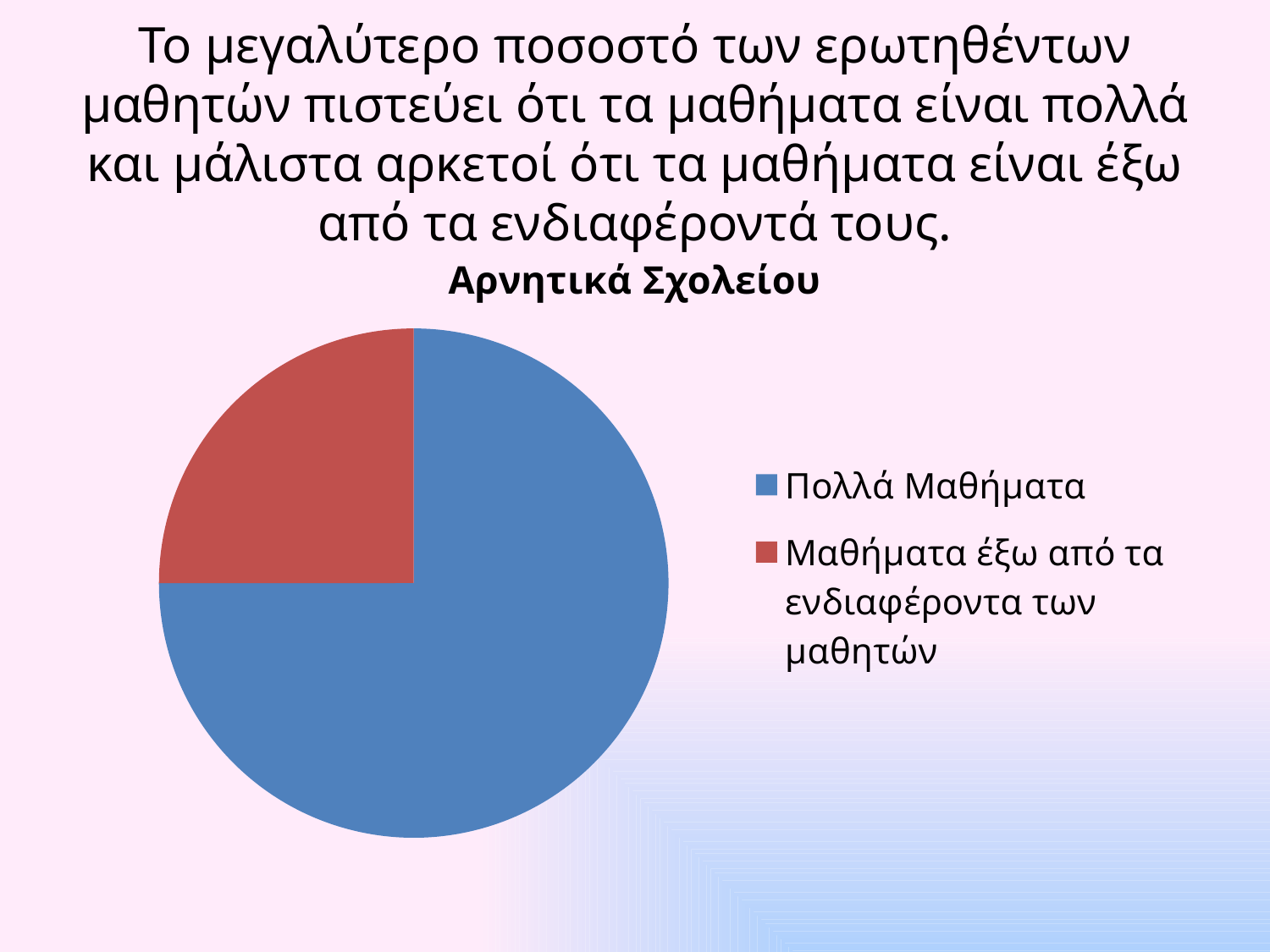
How many slices does the pie chart have? 2 What kind of chart is shown on the slide? pie chart Which slice is larger: Πολλά Μαθήματα or Μαθήματα έξω από τα ενδιαφέροντα των μαθητών? Πολλά Μαθήματα What colour is the slice for Πολλά Μαθήματα? blue Which category has the smallest slice of the pie? Μαθήματα έξω από τα ενδιαφέροντα των μαθητών Which category has the largest slice of the pie? Πολλά Μαθήματα What is the title of the chart? Αρνητικά Σχολείου How many entries does the legend list? 2